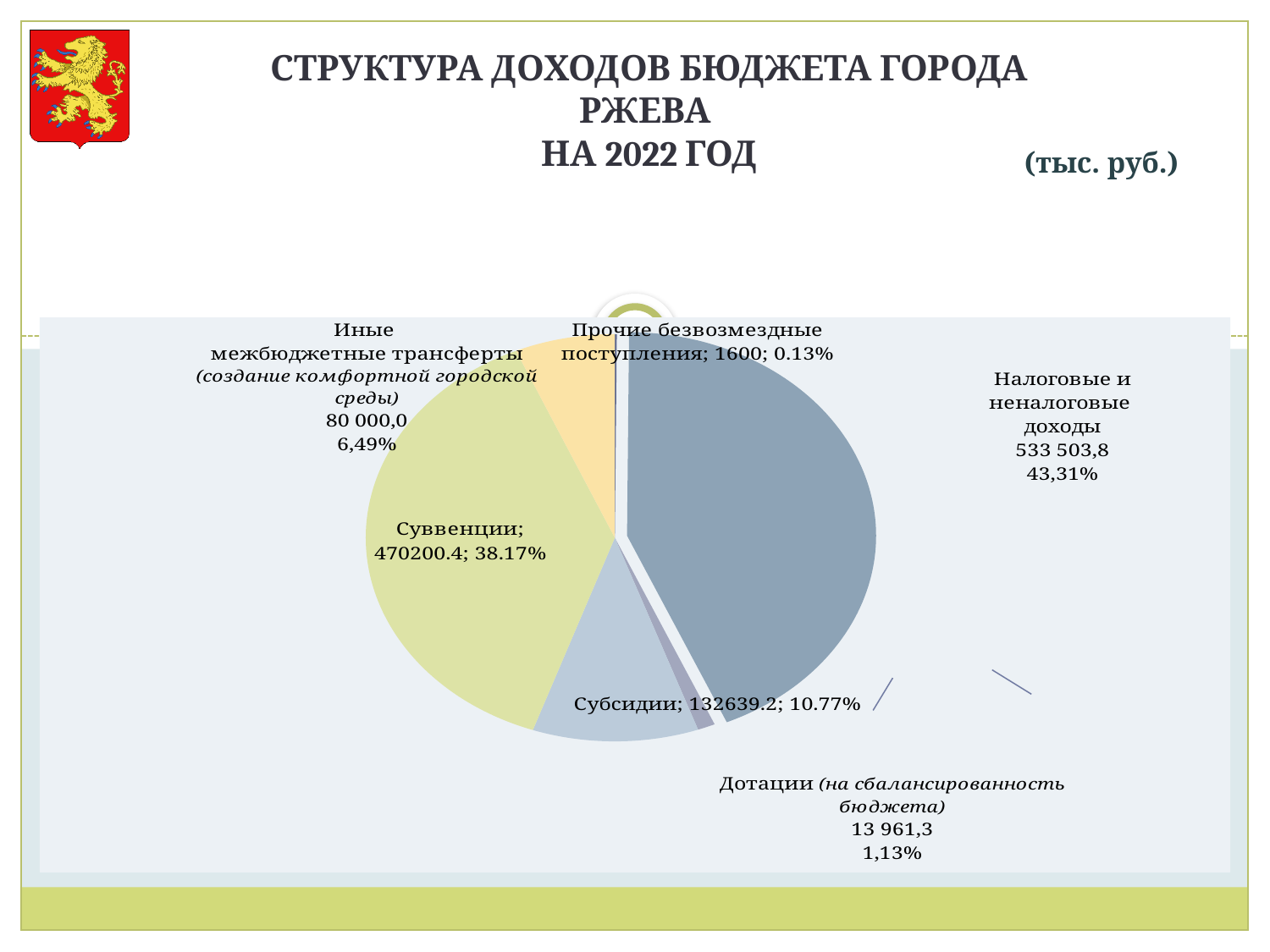
What share of the pie is Субвенции? 38.17% What is the value for Субсидии? 132639.2 Which category has the largest share of the pie? Налоговые и неналоговые доходы What share of the pie is Прочие безвозмездные поступления? 0.13% What kind of chart is shown on the slide? pie chart What is the value for Дотации (на сбалансированность бюджета)? 13 961,3 What unit is stated for the values on the slide? тыс. руб. How many slices does the pie chart have? 6 Which is larger, Субсидии or Иные межбюджетные трансферты? Субсидии What is the value for Налоговые и неналоговые доходы? 533 503,8 What share of the pie is Иные межбюджетные трансферты? 6,49% Which category has the smallest share of the pie? Прочие безвозмездные поступления